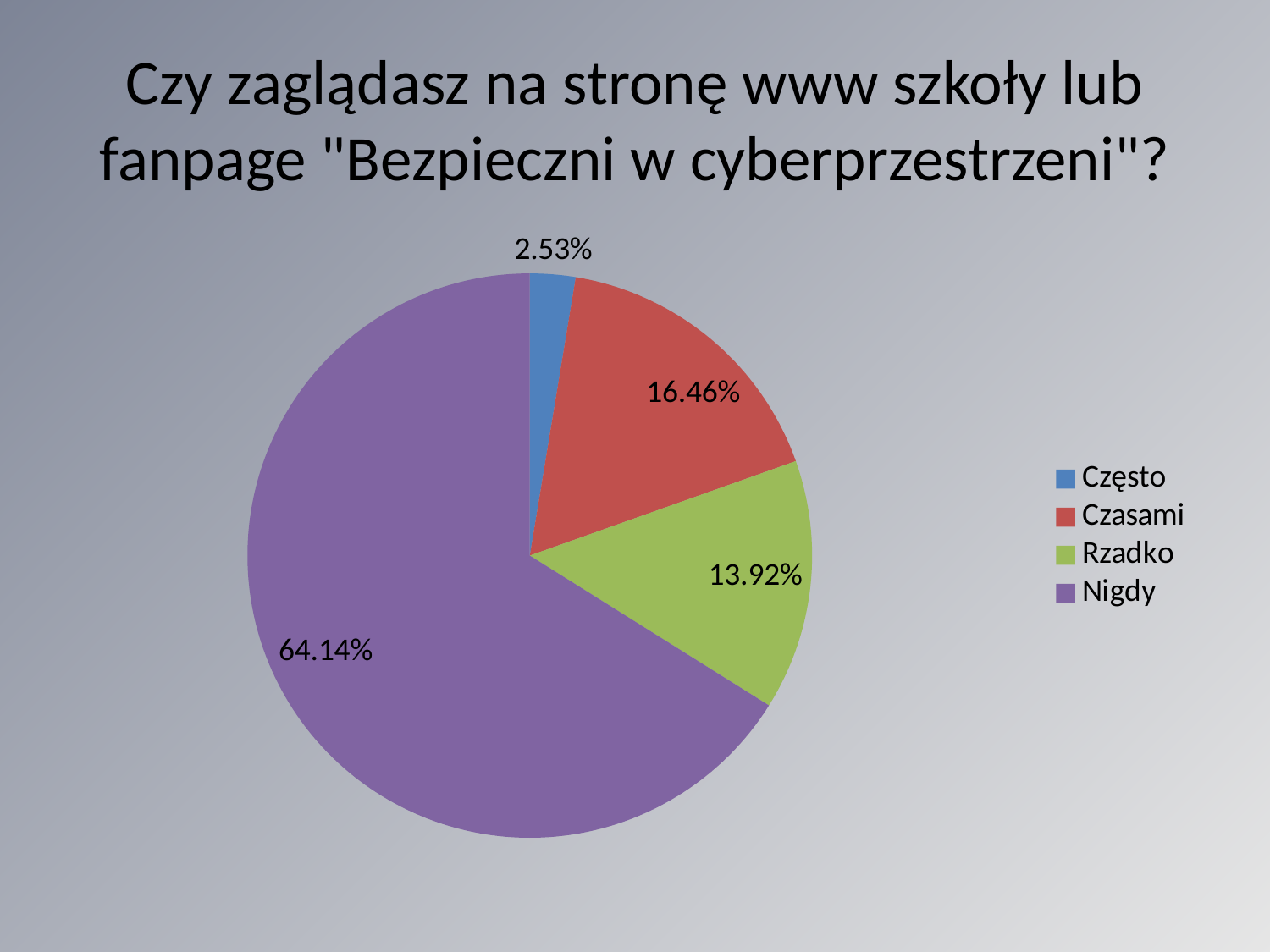
What percentage is shown for Czasami? 16.46% What colour is the slice for Nigdy? purple What is the difference in percentage points between Nigdy and Czasami? 47.68 How many categories does the legend list? 4 Which category has the largest share of the pie? Nigdy What kind of chart is shown on the slide? pie chart What is the difference in percentage points between Czasami and Rzadko? 2.54 Which category has the smallest share of the pie? Często What percentage is shown for Często? 2.53% What percentage is shown for Nigdy? 64.14% Which is larger, the share for Czasami or the share for Rzadko? Czasami What percentage is shown for Rzadko? 13.92%